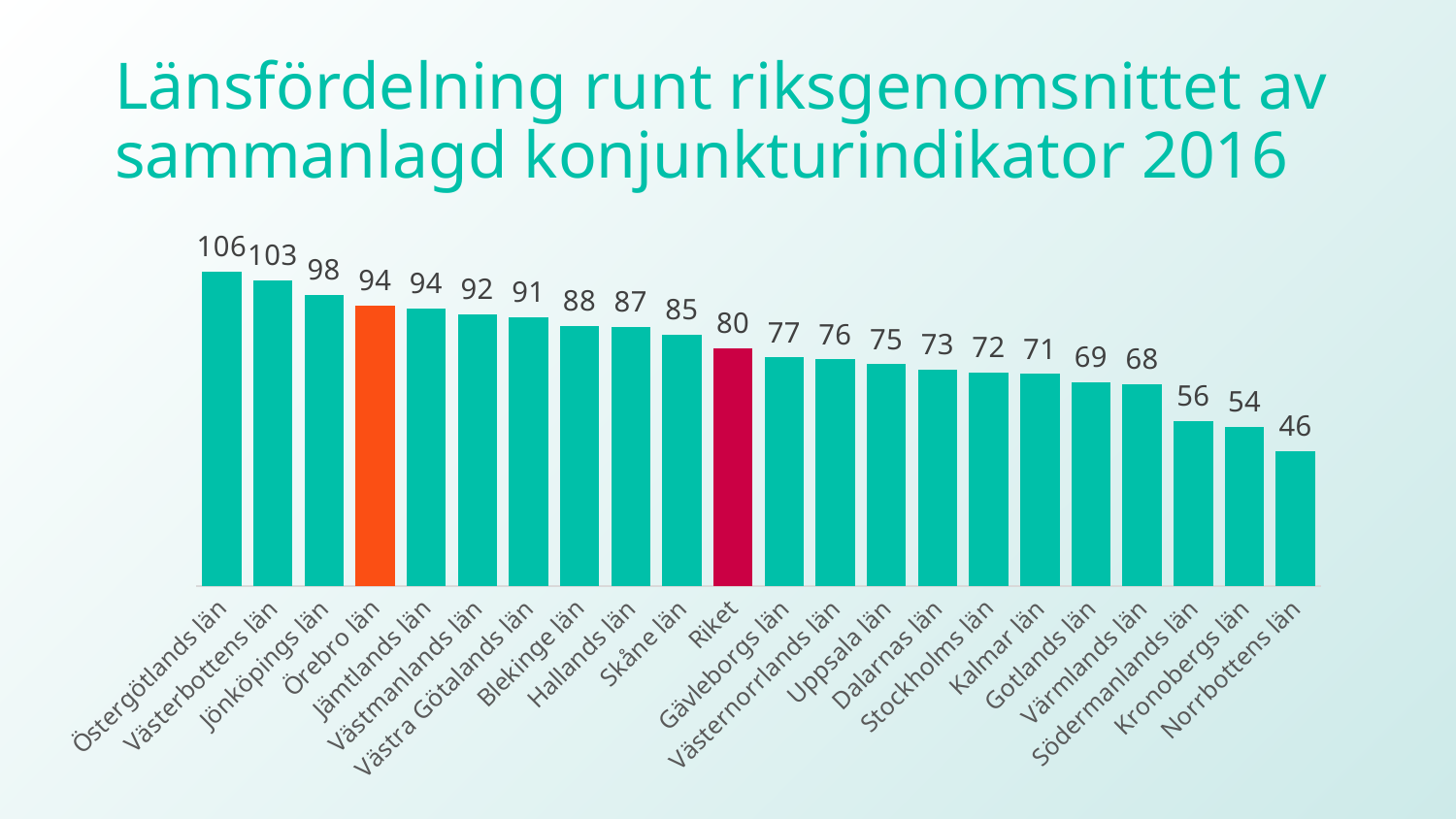
What is the value for Örebro län? 94 What is the difference between the values for Skåne län and Riket? 5 Which is larger, the value for Uppsala län or the value for Gotlands län? Uppsala län What is the value for Stockholms län? 72 What is the value for Riket? 80 Which category has the lowest value? Norrbottens län Which bar is coloured orange? Örebro län Do the values rise or fall from left to right along the x axis? Fall Which category has the highest value? Östergötlands län What kind of chart is shown on the slide? Bar chart What is the difference between the values for Östergötlands län and Norrbottens län? 60 How many bars are shown in the chart? 22